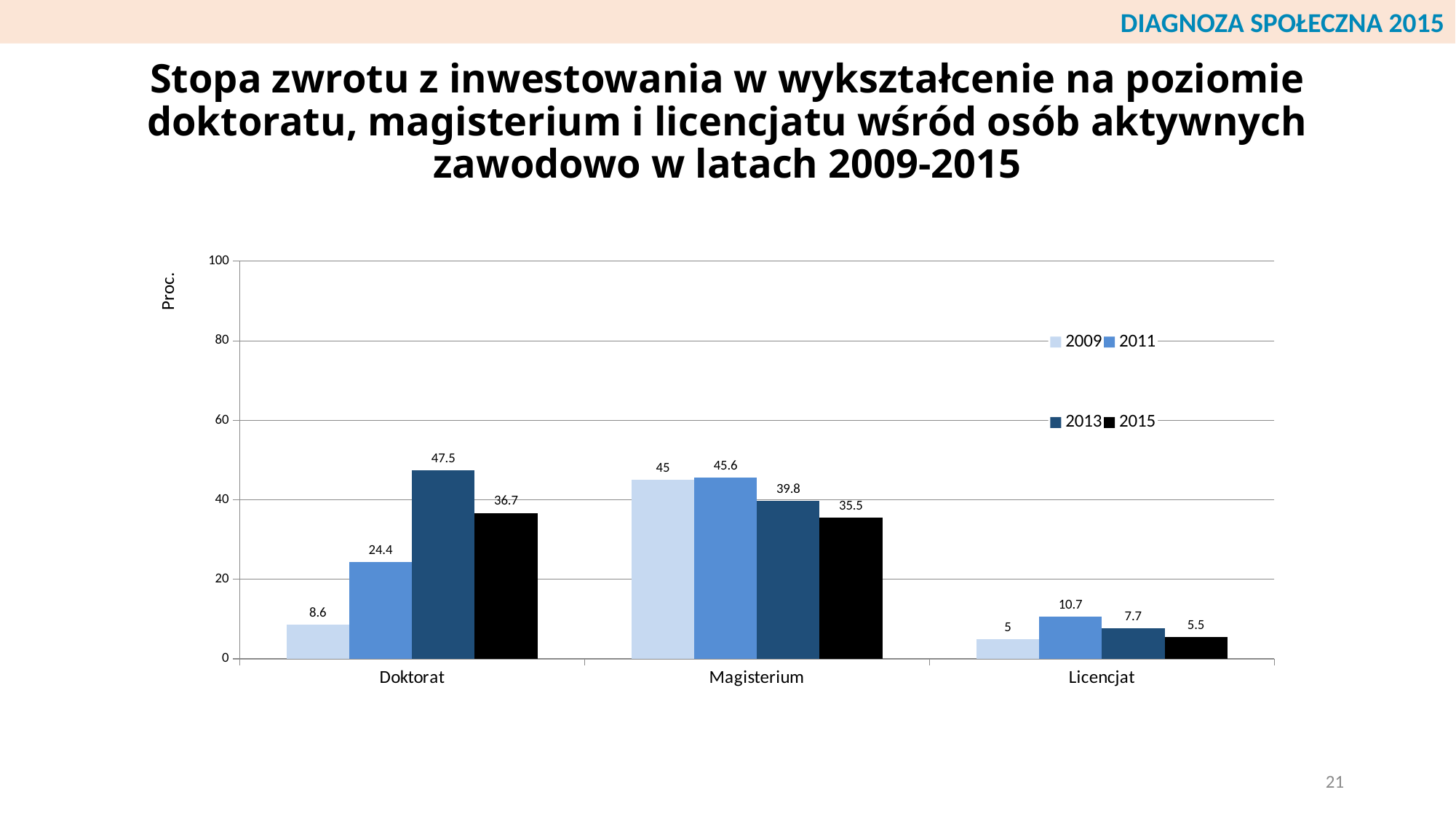
What is the label of the vertical axis? Proc. Is the value for Doktorat in 2011 greater or less than 20? greater What kind of chart is shown on the slide? bar chart What is the difference between the 2013 and 2015 values for Doktorat? 10.8 Which category has the lowest value in 2015? Licencjat Which is larger for Magisterium: the 2011 value or the 2013 value? 2011 What is the value for Licencjat in 2011? 10.7 Which category has the highest value in 2009? Magisterium How many categories are shown on the x axis? 3 What is the value for Doktorat in 2013? 47.5 What is the value for Magisterium in 2009? 45 How many series does the legend list? 4